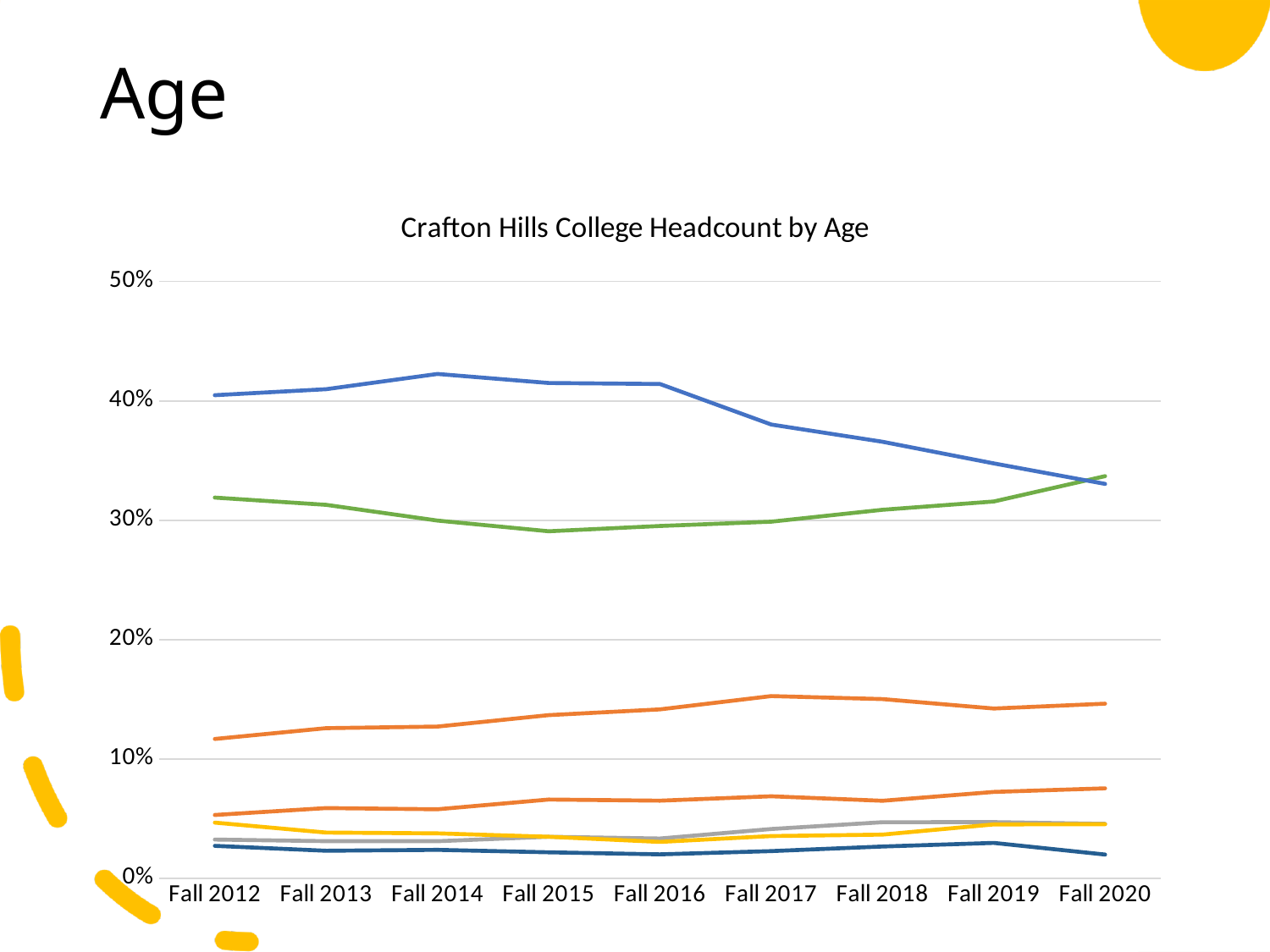
What is the highest value shown on the y axis? 50% Is the value of the blue line at Fall 2014 greater or less than 40%? greater How many terms are shown along the x axis of the chart? 9 Is the value of the green line at Fall 2012 greater or less than 30%? greater What is the title of the chart? Crafton Hills College Headcount by Age What kind of chart is shown on the slide? line chart Which line has the highest value at Fall 2014? the blue line Is the value of the blue line at Fall 2020 greater or less than 40%? less Does the blue line rise or fall from Fall 2016 to Fall 2020? fall At Fall 2012, which is larger: the blue line or the green line? the blue line